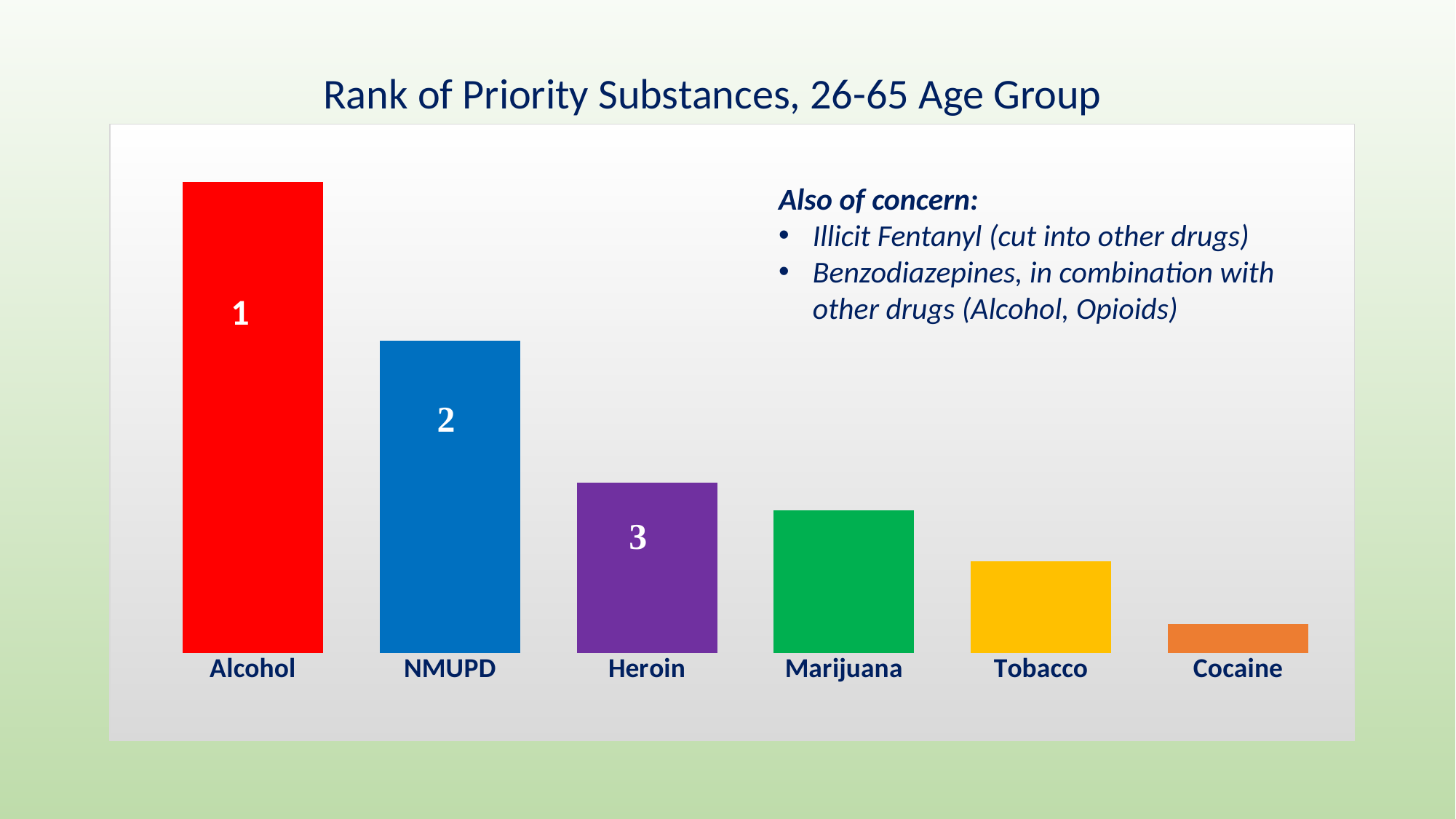
Which bar is taller, NMUPD or Marijuana? NMUPD What rank label is printed on the Heroin bar? 3 Which substance has the tallest bar in the chart? Alcohol What colour is the Heroin bar? purple How many substances are shown as bars in the chart? 6 What rank label is printed on the NMUPD bar? 2 What kind of chart is shown on the slide? bar chart Which bar is taller, Tobacco or Cocaine? Tobacco Do the bars rise or fall from left to right across the chart? fall What is the title of the chart? Rank of Priority Substances, 26-65 Age Group What rank label is printed on the Alcohol bar? 1 Which substance has the shortest bar in the chart? Cocaine